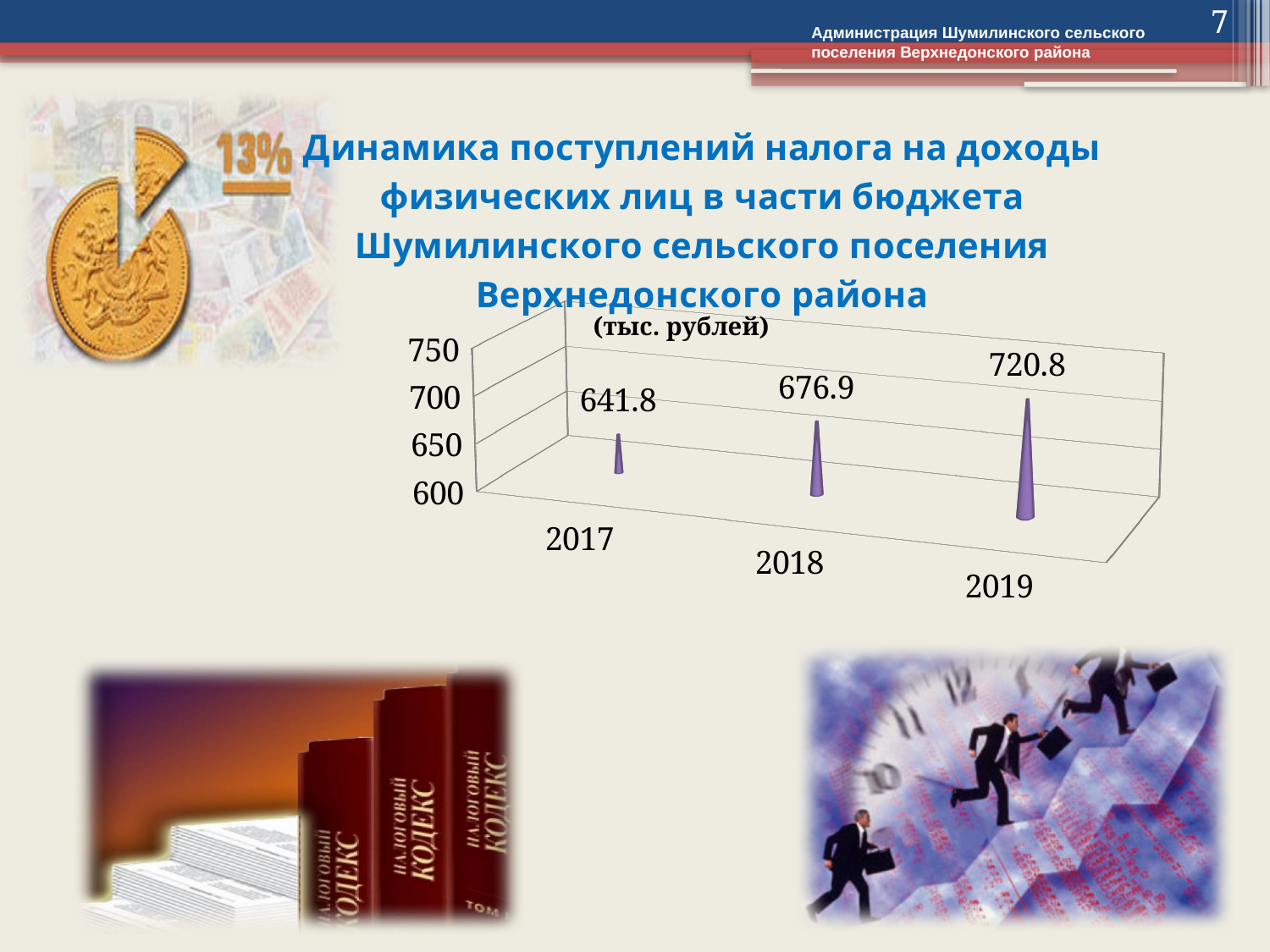
What is the value for 2017? 641.8 What is the value for 2019? 720.8 What is the difference between the values for 2018 and 2017? 35.1 Do the values rise or fall from 2017 to 2019? rise How many years are shown on the chart? 3 What is the value for 2018? 676.9 Which is larger, the value for 2018 or the value for 2019? 2019 Which year has the lowest value? 2017 Is the value for 2019 greater or less than 700? greater What kind of chart is shown on the slide? bar chart What is the difference between the values for 2019 and 2017? 79.0 Which year has the highest value? 2019